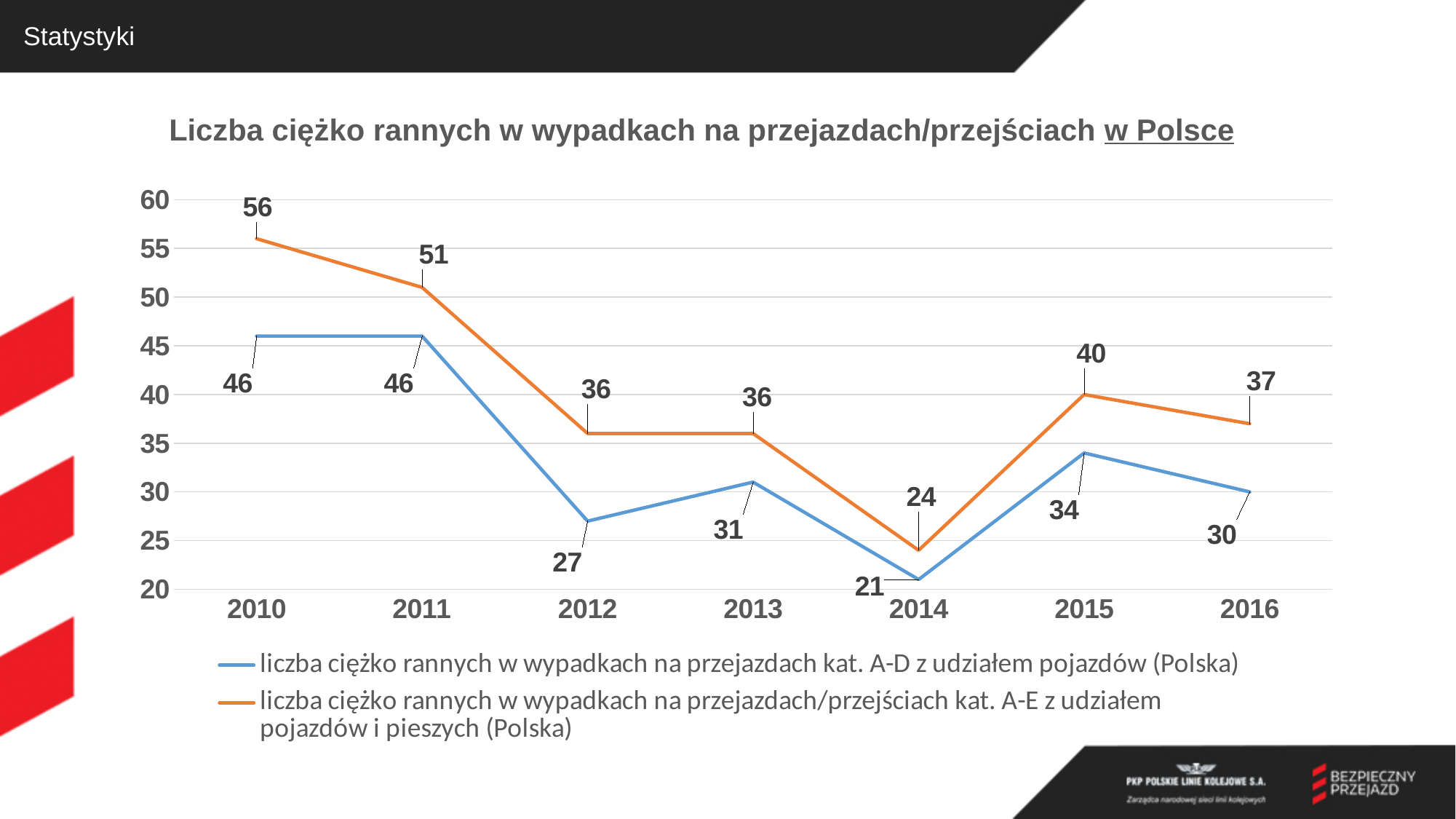
How many years are shown on the x axis? 7 In which year is the blue series (kat. A-D) at its highest? 2010 and 2011 What kind of chart is shown on the slide? line chart In which year is the orange series (kat. A-E) at its lowest? 2014 What is the difference between the orange and blue series values in 2015? 6 What is the value of the orange series (kat. A-E, pojazdów i pieszych) in 2010? 56 How many series does the legend list? 2 What is the value of the blue series (kat. A-D, pojazdów) in 2016? 30 What is the difference between the orange series values in 2010 and 2016? 19 Which is larger: the blue series value in 2013 or in 2012? 2013 What is the value of the blue series (kat. A-D, pojazdów) in 2014? 21 Does the orange series rise or fall from 2010 to 2014? fall